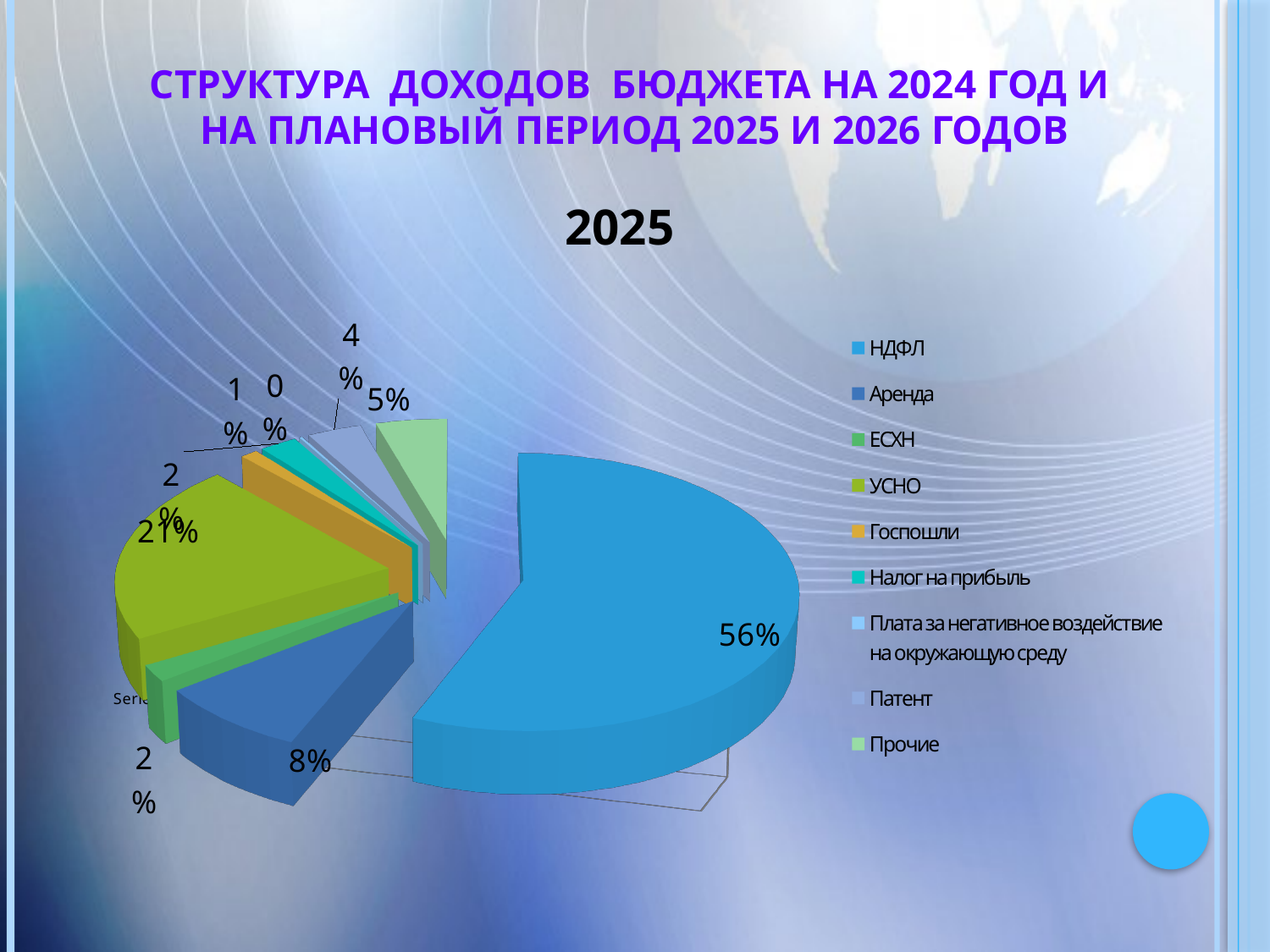
Which category has the largest slice of the pie? НДФЛ How many categories does the legend list? 9 What share of the pie does НДФЛ account for? 56% What year is shown as the chart's title? 2025 What kind of chart is shown on the slide? pie chart What is the value shown for Аренда? 8% Which is larger, the slice for УСНО or the slice for Аренда? УСНО What is the value shown for Патент? 4% What is the value shown for Прочие? 5% What is the difference in percentage points between НДФЛ and УСНО? 35 What is the value shown for УСНО? 21% Which category has the smallest slice of the pie? Плата за негативное воздействие на окружающую среду